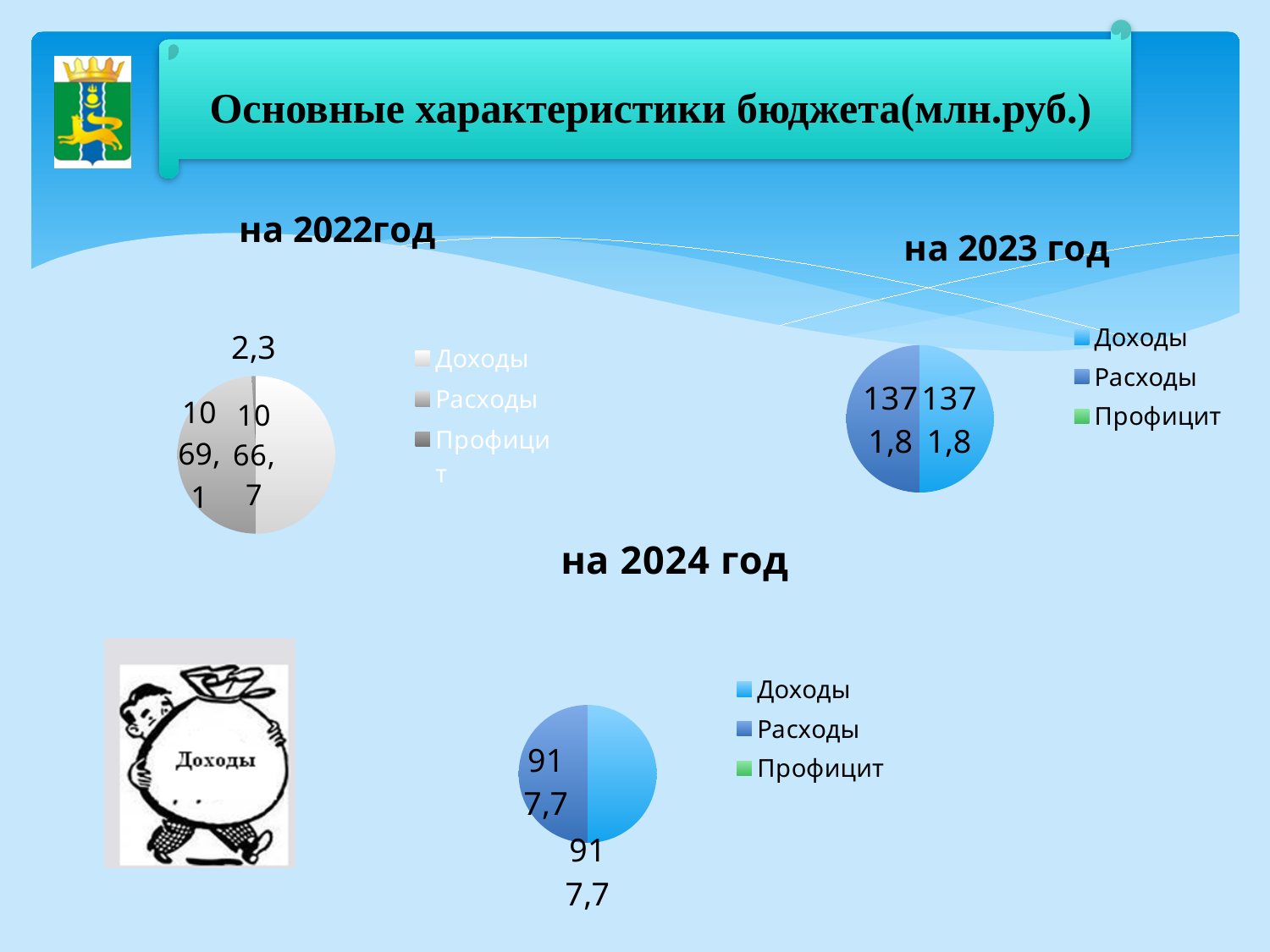
What kind of chart is used for "на 2023 год"? pie chart In the "на 2022год" chart, what is the value for Расходы? 1069,1 How many series does the legend of the "на 2024 год" chart list? 3 In the "на 2023 год" chart, what is the value for Расходы? 1371,8 In the "на 2022год" chart, what is the value for Профицит? 2,3 In the "на 2022год" chart, what is the value for Доходы? 1066,7 In the "на 2024 год" chart, what is the value for Расходы? 917,7 In the "на 2024 год" chart, what is the value for Доходы? 917,7 In the "на 2022год" chart, which slice is the smallest? Профицит In the "на 2023 год" chart, what is the value for Доходы? 1371,8 How many pie charts are shown on the slide? 3 What colour represents Профицит in the legend of the "на 2024 год" chart? green